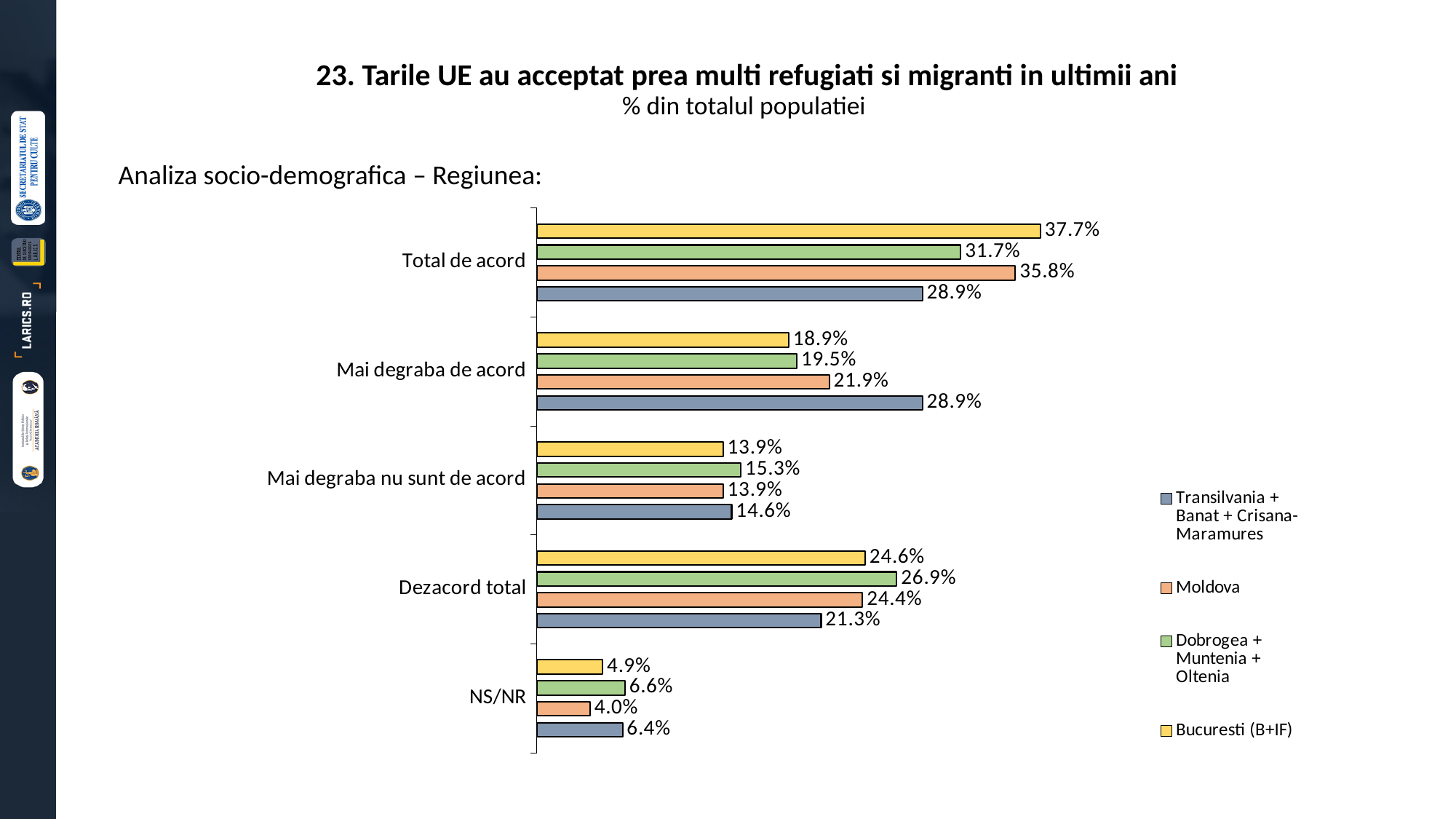
What is the value for Dobrogea + Muntenia + Oltenia in the 'NS/NR' category? 6.6% How many response categories are shown on the chart? 5 What is the value for Transilvania + Banat + Crisana-Maramures in the 'Dezacord total' category? 21.3% What is the value for Bucuresti (B+IF) in the 'Total de acord' category? 37.7% Which region has the lowest value in the 'NS/NR' category? Moldova How many series does the legend list? 4 What kind of chart is shown on the slide? bar chart What is the value for Moldova in the 'Mai degraba de acord' category? 21.9% What is the difference between Bucuresti (B+IF) and Transilvania + Banat + Crisana-Maramures in the 'Total de acord' category? 8.8% Which region has the highest value in the 'Total de acord' category? Bucuresti (B+IF) In the 'Mai degraba de acord' category, which is larger: Transilvania + Banat + Crisana-Maramures or Bucuresti (B+IF)? Transilvania + Banat + Crisana-Maramures What is the subtitle shown under the chart title? % din totalul populatiei